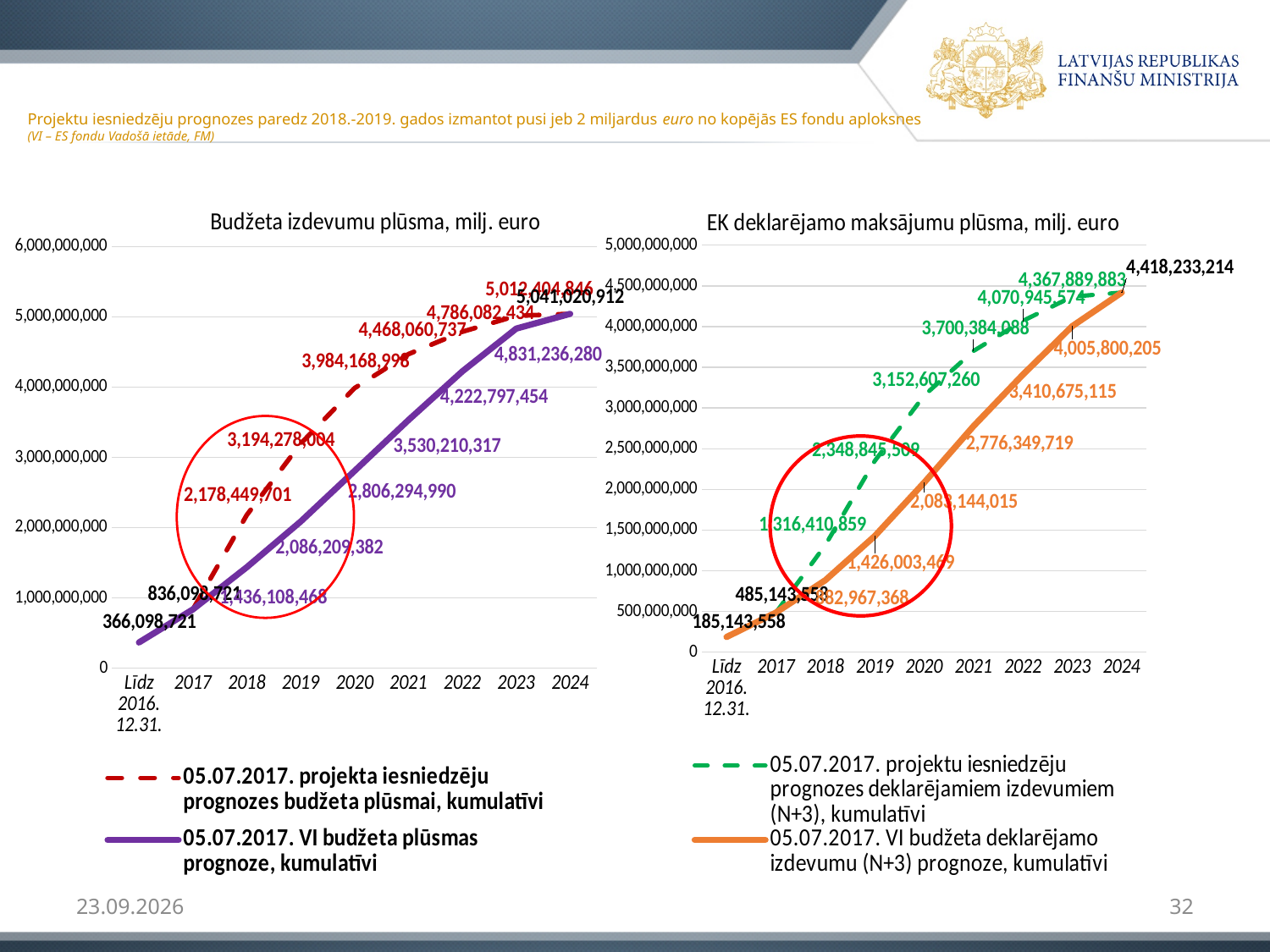
What kind of chart is the left chart titled 'Budžeta izdevumu plūsma, milj. euro'? Line chart In the left chart 'Budžeta izdevumu plūsma, milj. euro', what is the difference between the two series' values for 2022 (4,786,082,434 and 4,222,797,454)? 563,284,980 In the right chart 'EK deklarējamo maksājumu plūsma, milj. euro', what is the value of the '05.07.2017. projektu iesniedzēju prognozes deklarējamiem izdevumiem (N+3), kumulatīvi' series for 2021? 3,700,384,088 In the right chart 'EK deklarējamo maksājumu plūsma, milj. euro', what is the difference between the two series' values for 2023 (4,367,889,883 and 4,005,800,205)? 362,089,678 In the right chart 'EK deklarējamo maksājumu plūsma, milj. euro', does the '05.07.2017. VI budžeta deklarējamo izdevumu (N+3) prognoze, kumulatīvi' line rise or fall from 2017 to 2024? Rise In the left chart 'Budžeta izdevumu plūsma, milj. euro', what is the value of the '05.07.2017. VI budžeta plūsmas prognoze, kumulatīvi' series for 2022? 4,222,797,454 In the right chart 'EK deklarējamo maksājumu plūsma, milj. euro', what is the value of the '05.07.2017. VI budžeta deklarējamo izdevumu (N+3) prognoze, kumulatīvi' series for 2023? 4,005,800,205 In the right chart 'EK deklarējamo maksājumu plūsma, milj. euro', what value is labelled for 2024? 4,418,233,214 How many categories are shown on the x axis of the left chart 'Budžeta izdevumu plūsma, milj. euro'? 9 How many series does the legend of the left chart 'Budžeta izdevumu plūsma, milj. euro' list? 2 In the left chart 'Budžeta izdevumu plūsma, milj. euro', which series has the higher value for 2020? 05.07.2017. projekta iesniedzēju prognozes budžeta plūsmai, kumulatīvi In the left chart 'Budžeta izdevumu plūsma, milj. euro', what is the value of the '05.07.2017. projekta iesniedzēju prognozes budžeta plūsmai, kumulatīvi' series for 2021? 4,468,060,737